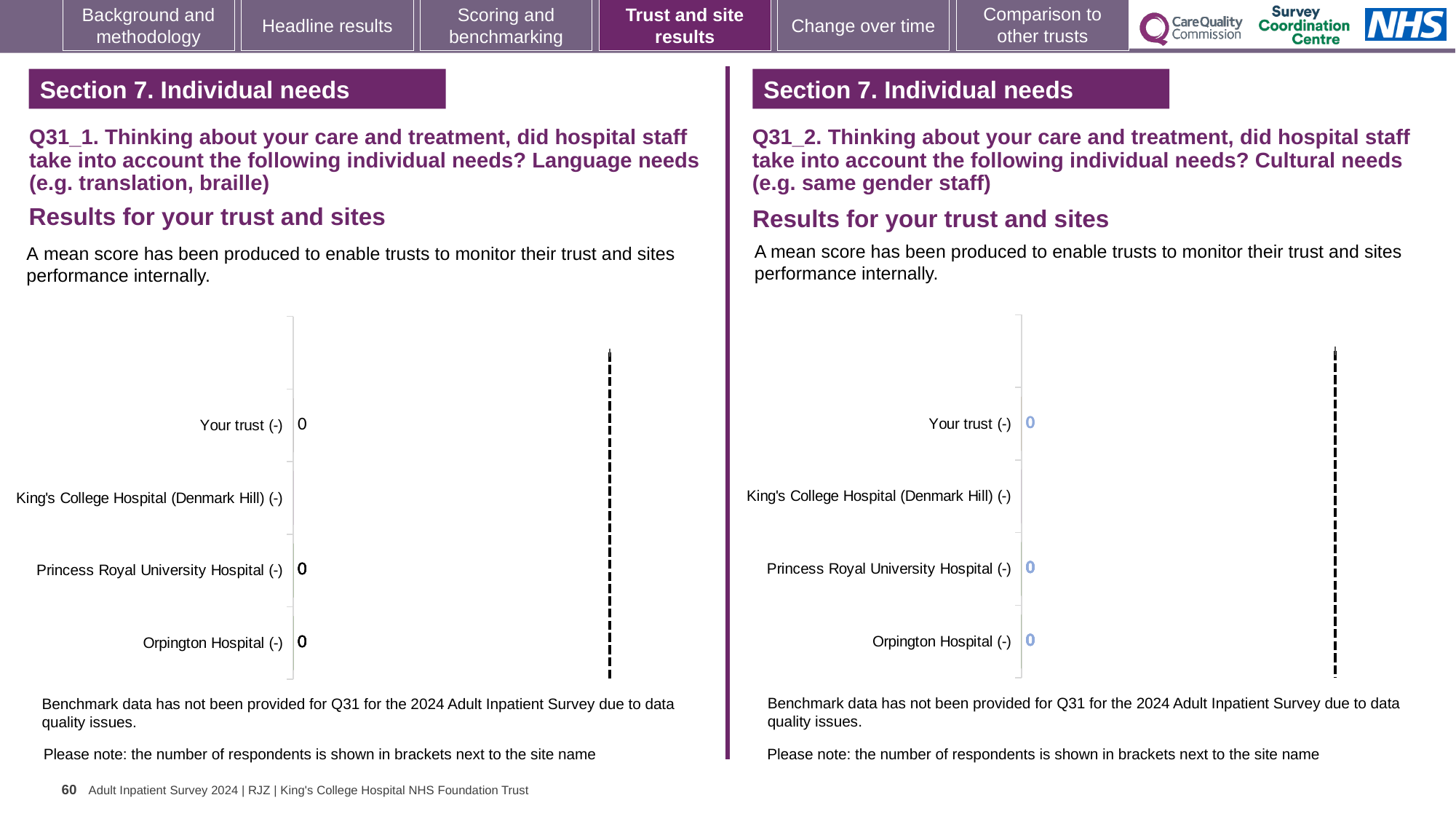
In the right chart (Q31_2, Cultural needs), what value is shown for Your trust? 0 In the right chart (Q31_2, Cultural needs), which category is listed first (at the top) on the vertical axis? Your trust (-) How many categories are listed on the vertical axis of the right chart (Q31_2, Cultural needs)? 4 In the left chart (Q31_1, Language needs), what value is shown for Princess Royal University Hospital? 0 In the left chart (Q31_1, Language needs), what is the difference between the values for Your trust and Orpington Hospital? 0 In the left chart (Q31_1, Language needs), what value is shown for Your trust? 0 In the left chart (Q31_1, Language needs), what value is shown for Orpington Hospital? 0 How many categories are listed on the vertical axis of the left chart (Q31_1, Language needs)? 4 In the right chart (Q31_2, Cultural needs), what value is shown for Orpington Hospital? 0 According to the note below the left chart, why has benchmark data not been provided for Q31? Due to data quality issues In the right chart (Q31_2, Cultural needs), what value is shown for Princess Royal University Hospital? 0